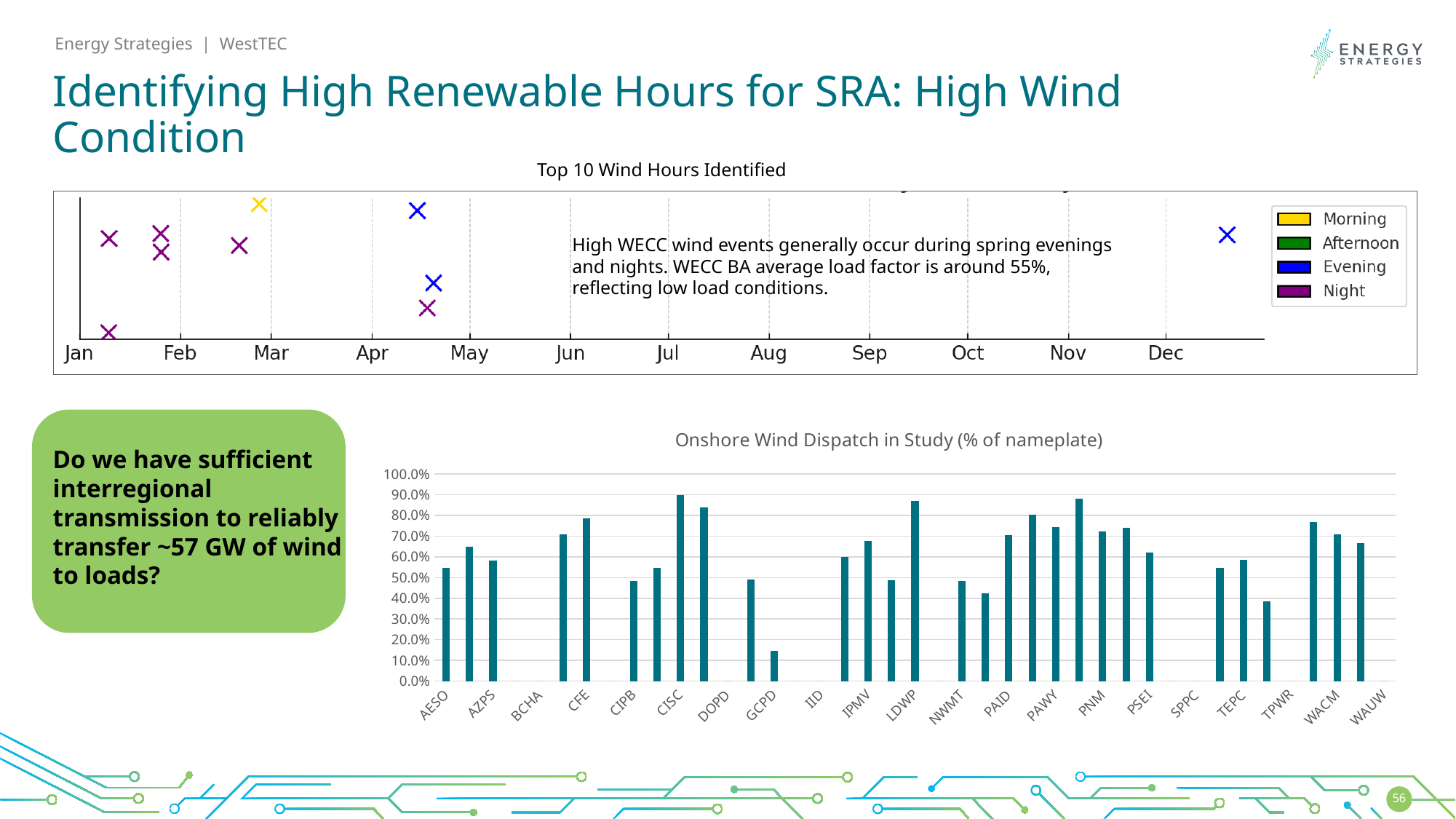
What kind of chart is the 'Onshore Wind Dispatch in Study (% of nameplate)' chart? bar chart In the 'Onshore Wind Dispatch in Study (% of nameplate)' chart, is the shortest plotted bar greater or less than 20.0%? less In the 'Top 10 Wind Hours Identified' chart, how many Morning markers are plotted? 1 What is the highest value shown on the y axis of the 'Onshore Wind Dispatch in Study (% of nameplate)' chart? 100.0% In the 'Onshore Wind Dispatch in Study (% of nameplate)' chart, how many categories are labelled on the x axis? 21 In the 'Onshore Wind Dispatch in Study (% of nameplate)' chart, is the tallest bar greater or less than 80.0%? greater In the 'Top 10 Wind Hours Identified' chart, which colour represents Night? purple In the 'Top 10 Wind Hours Identified' chart, how many Afternoon markers are plotted? 0 In the 'Top 10 Wind Hours Identified' chart, how many entries does the legend list? 4 What kind of chart is the 'Top 10 Wind Hours Identified' chart? scatter plot In the 'Top 10 Wind Hours Identified' chart, which time-of-day category has the most markers? Night